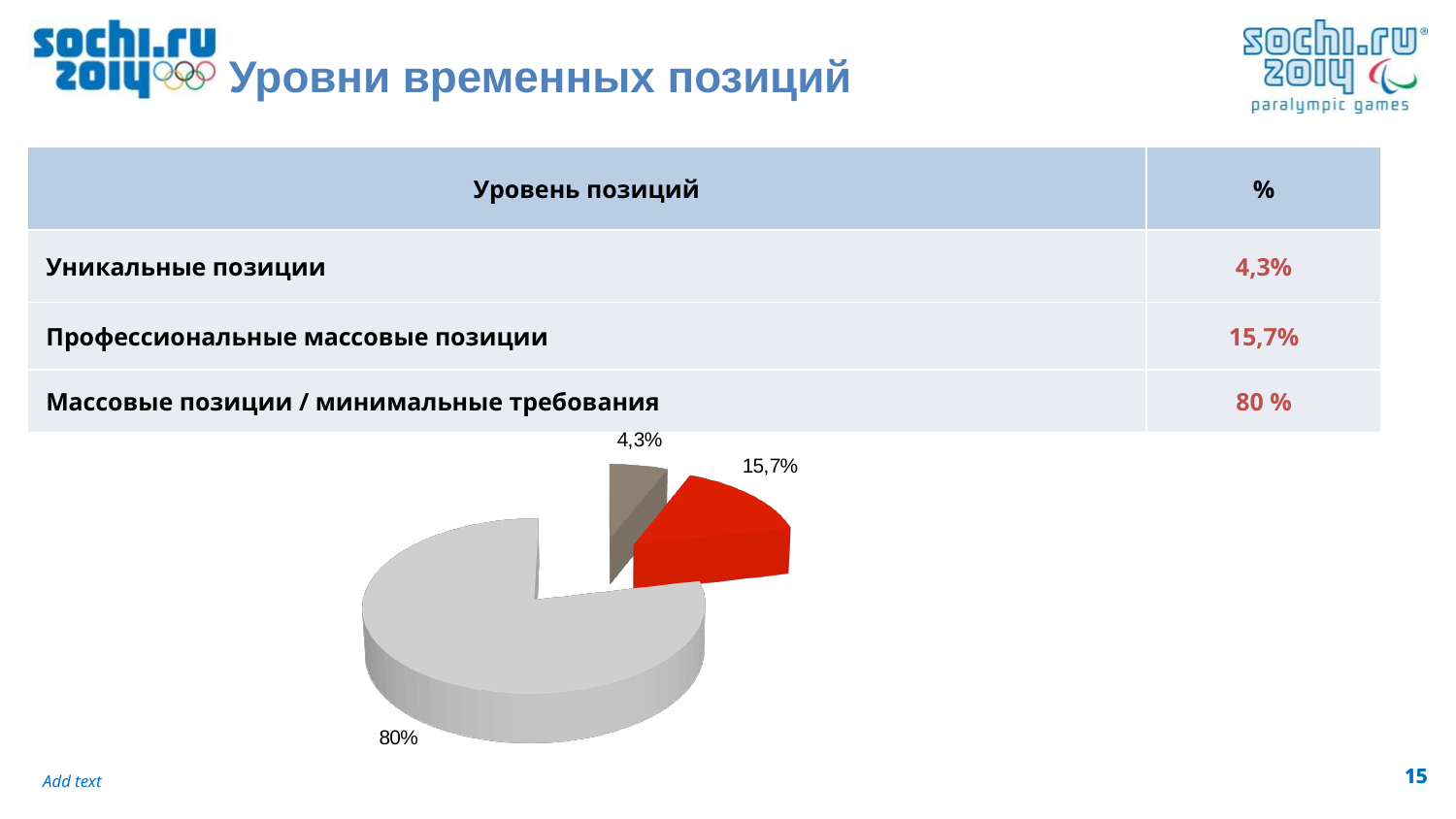
Which is larger in the pie chart: the red slice or the brown slice? The red slice What value is shown on the brown slice of the pie chart? 4,3% What colour is the largest slice of the pie chart? Grey What value is shown on the grey slice of the pie chart? 80% How many slices does the pie chart have? 3 According to the table, what share do Уникальные позиции have? 4,3% What value is shown on the red slice of the pie chart? 15,7% What is the difference between the 15,7% slice and the 4,3% slice? 11,4% What kind of chart is shown on the slide? Pie chart What is the value of the largest slice of the pie chart? 80% According to the table, which position level corresponds to the 80% slice? Массовые позиции / минимальные требования What is the value of the smallest slice of the pie chart? 4,3%